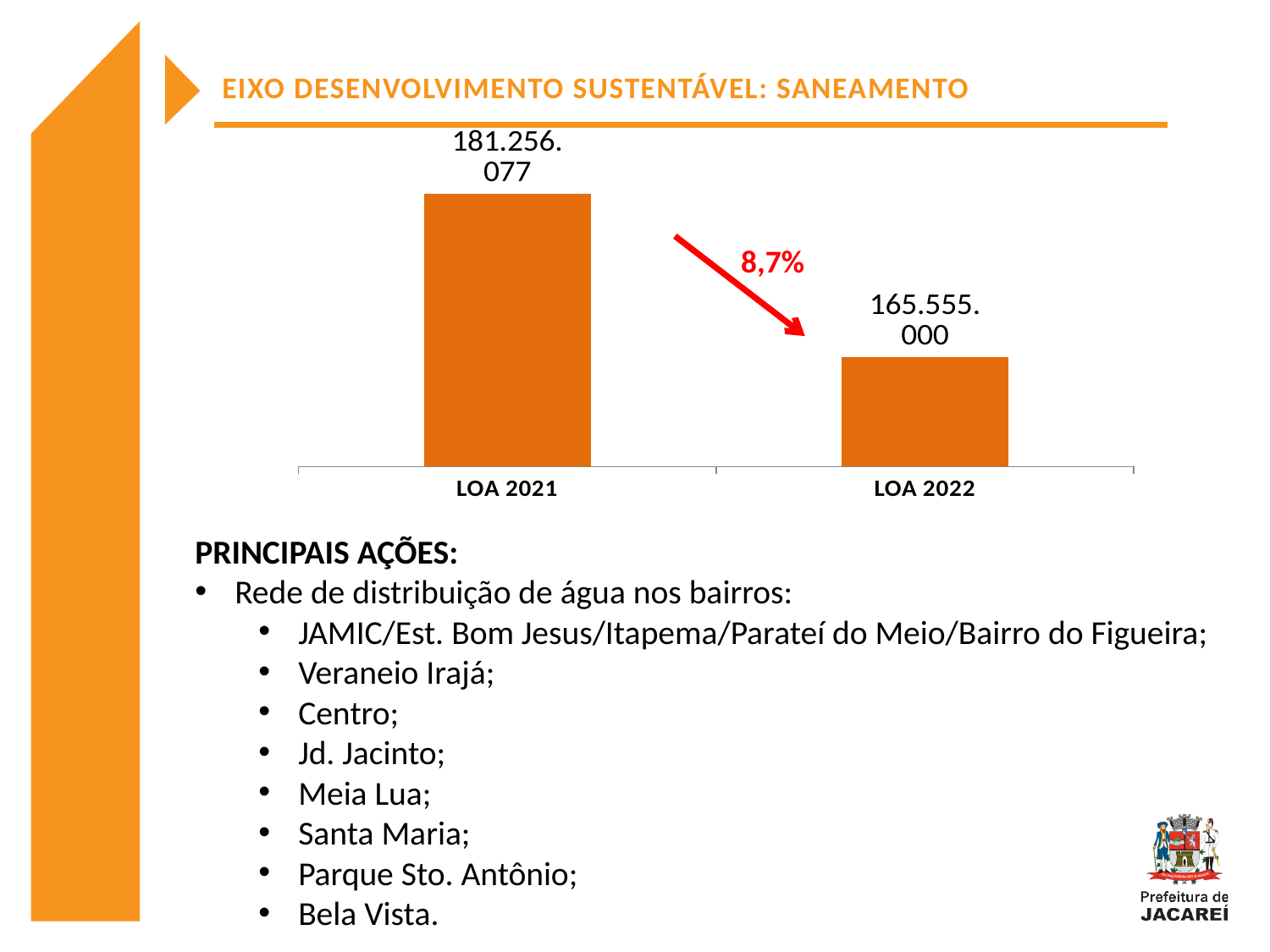
What kind of chart is shown on the slide? Bar chart What percentage change is annotated next to the red arrow on the chart? 8,7% Which is larger, the value for LOA 2021 or LOA 2022? LOA 2021 What is the value for LOA 2022? 165.555.000 Which category has the highest value? LOA 2021 Do the values rise or fall from LOA 2021 to LOA 2022? Fall What is the value for LOA 2021? 181.256.077 What is the difference between the values for LOA 2021 and LOA 2022? 15.701.077 What colour are the bars in the chart? Orange How many categories are shown in the chart? 2 Which category has the lowest value? LOA 2022